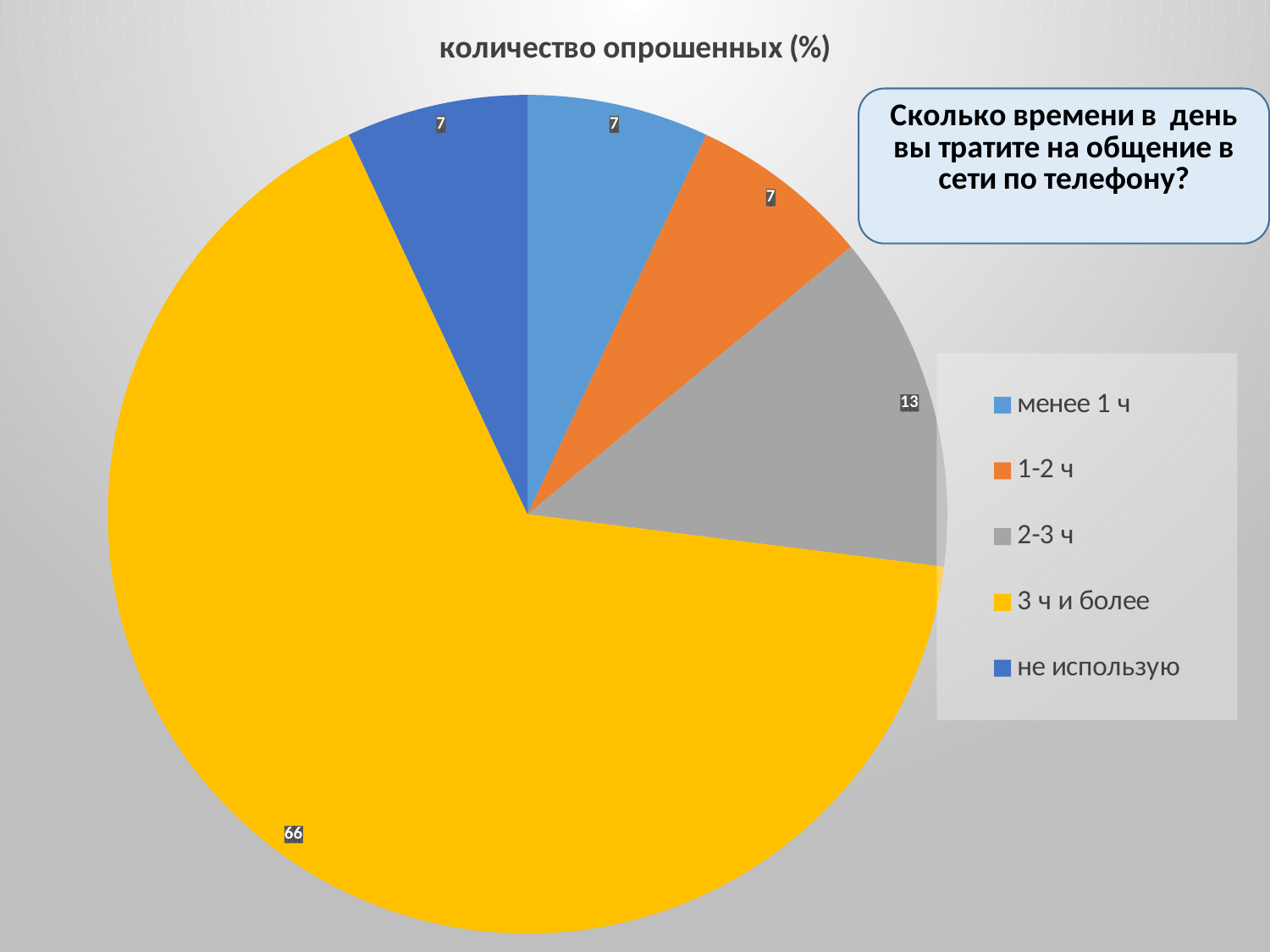
What is the value for the slice '3 ч и более'? 66 What is the value for the slice 'не использую'? 7 How many slices does the pie chart have? 5 Which is larger, the value for '2-3 ч' or the value for '1-2 ч'? 2-3 ч What colour is the slice for '3 ч и более'? yellow What is the value for the slice '2-3 ч'? 13 What is the title of the chart? количество опрошенных (%) Which category has the largest slice of the pie? 3 ч и более What is the difference between the values for '2-3 ч' and '1-2 ч'? 6 What type of chart is shown on the slide? pie chart What is the difference between the values for '3 ч и более' and '2-3 ч'? 53 What is the value for the slice 'менее 1 ч'? 7